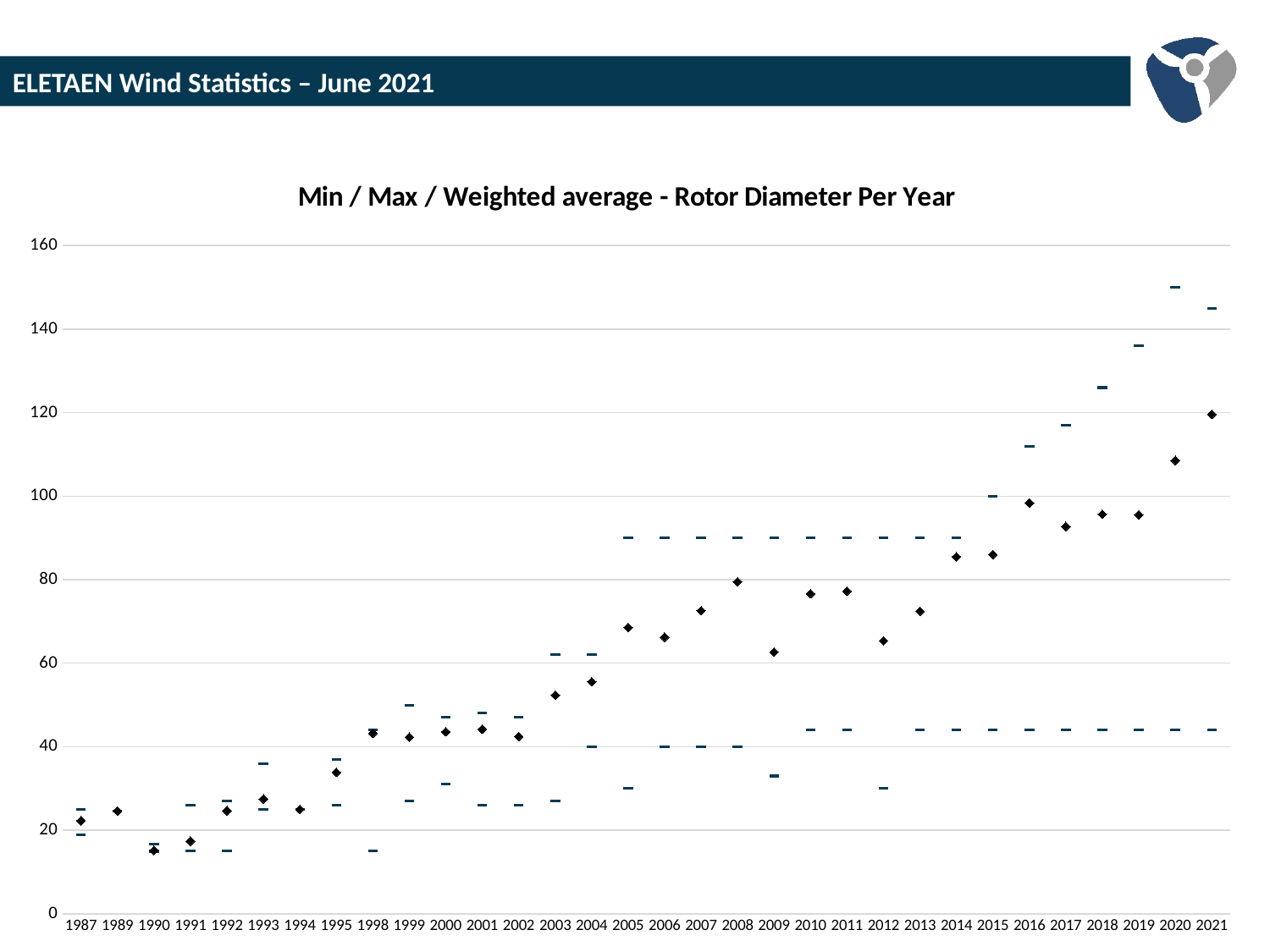
Is the weighted average rotor diameter (diamond marker) for 2003 greater or less than 60? less Is the maximum rotor diameter value for 2020 greater or less than 140? greater Is the weighted average rotor diameter (diamond marker) for 1990 greater or less than 20? less Which year has the lowest weighted average rotor diameter (diamond marker)? 1990 Which year has the highest weighted average rotor diameter (diamond marker)? 2021 What kind of chart is shown on the slide? Scatter chart What is the title of the chart? Min / Max / Weighted average - Rotor Diameter Per Year Is the weighted average rotor diameter (diamond marker) larger in 2010 or in 2012? 2010 How many years are shown on the x axis of the chart? 32